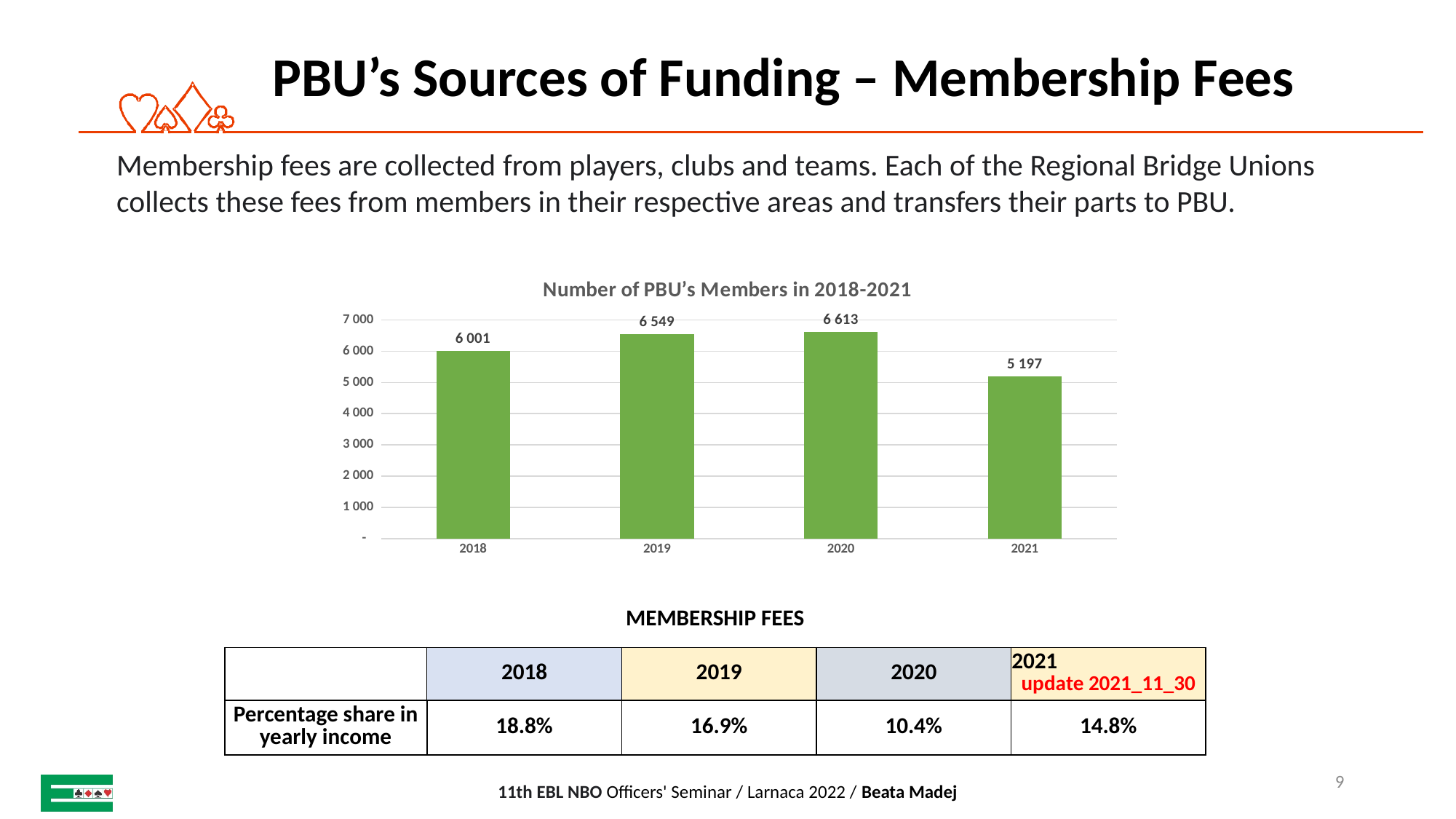
Which year has the lowest number of PBU's members? 2021 Which year has more members, 2018 or 2019? 2019 What is the difference in the number of members between 2019 and 2018? 548 Does the number of members rise or fall from 2020 to 2021? fall What kind of chart is shown on the slide? bar chart Is the number of members in 2021 greater or less than 6 000? less How many years are shown on the chart? 4 Which year has the highest number of PBU's members? 2020 What is the difference in the number of members between 2020 and 2021? 1 416 What is the title of the chart? Number of PBU's Members in 2018-2021 What is the number of PBU's members in 2021? 5 197 What is the number of PBU's members in 2018? 6 001